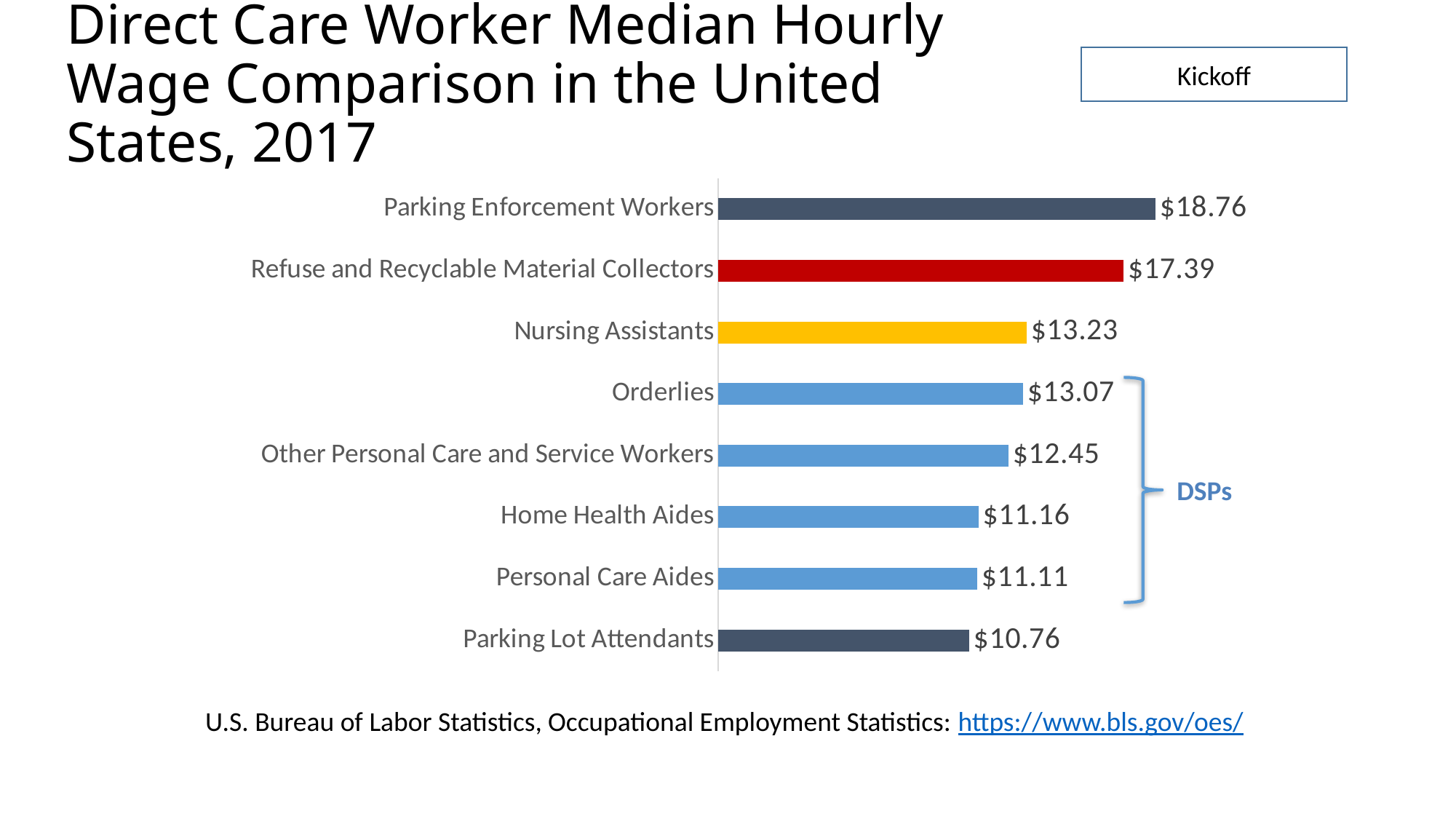
What kind of chart is shown on the slide? Bar chart Which occupation has the highest median hourly wage? Parking Enforcement Workers What is the difference between the median hourly wage of Orderlies and Other Personal Care and Service Workers? $0.62 What is the difference between the median hourly wage of Parking Enforcement Workers and Personal Care Aides? $7.65 Which group of occupations is labelled with the bracket 'DSPs'? Orderlies, Other Personal Care and Service Workers, Home Health Aides, Personal Care Aides How many occupations are shown in the chart? 8 What is the median hourly wage for Nursing Assistants? $13.23 What colour is the bar for Nursing Assistants? Yellow What is the median hourly wage for Home Health Aides? $11.16 Which has a higher median hourly wage, Nursing Assistants or Refuse and Recyclable Material Collectors? Refuse and Recyclable Material Collectors Which occupation has the lowest median hourly wage? Parking Lot Attendants What is the median hourly wage for Refuse and Recyclable Material Collectors? $17.39